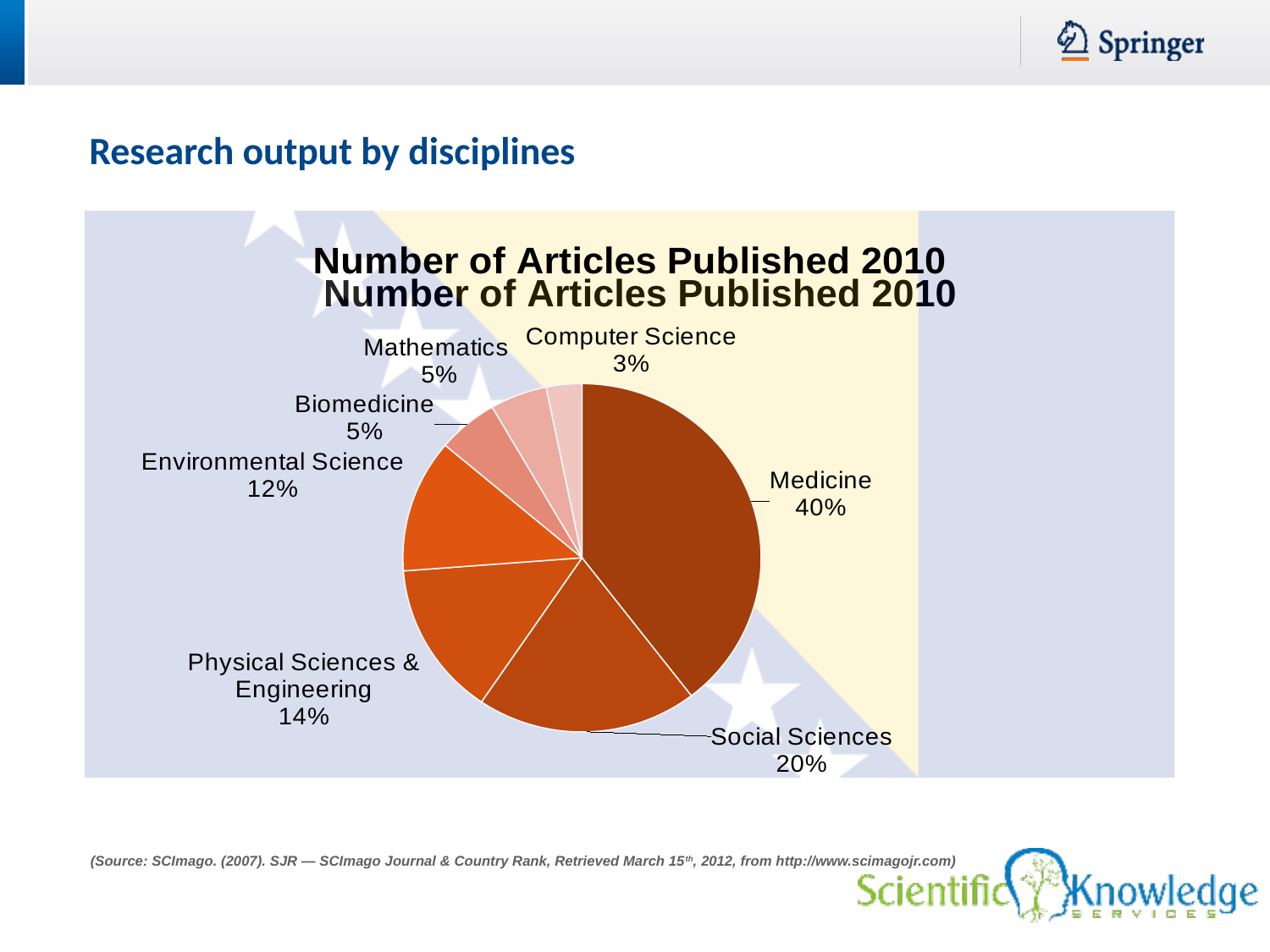
Which discipline has the smallest share of the pie? Computer Science What is the title of the chart? Number of Articles Published 2010 What type of chart is shown on the slide? pie chart What share of the pie does Medicine represent? 40% What percentage is shown for Physical Sciences & Engineering? 14% What percentage is shown for Computer Science? 3% Which has a larger share, Environmental Science or Physical Sciences & Engineering? Physical Sciences & Engineering What is the difference in percentage points between Medicine and Social Sciences? 20 Which discipline has the largest share of the pie? Medicine How many disciplines (slices) are shown in the pie chart? 7 What percentage is shown for Social Sciences? 20% What percentage is shown for Environmental Science? 12%